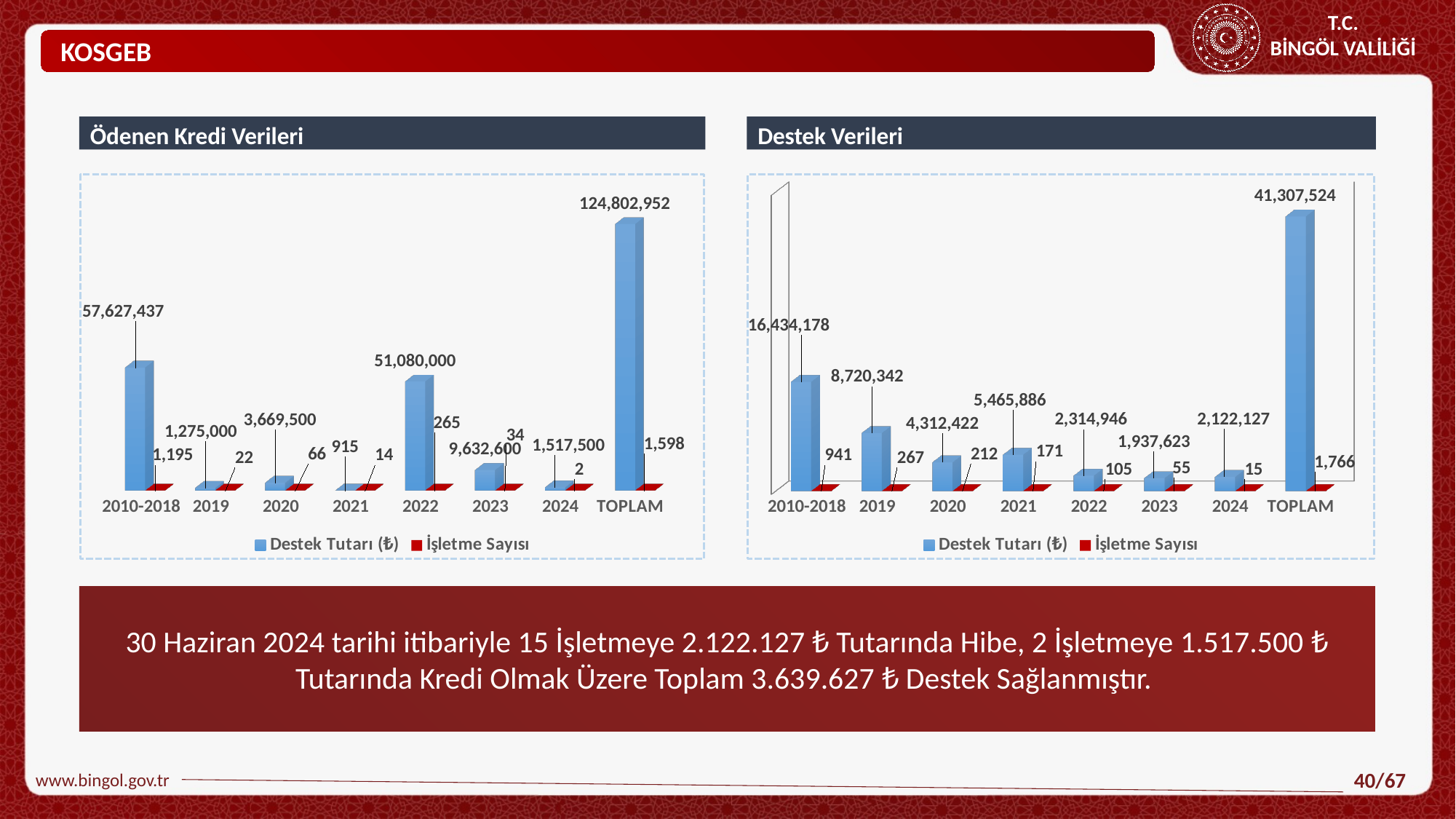
In the 'Destek Verileri' chart, what is the Destek Tutarı (₺) value for 2019? 8,720,342 In the 'Ödenen Kredi Verileri' chart, what is the İşletme Sayısı value for 2010-2018? 1,195 In the 'Ödenen Kredi Verileri' chart, what is the Destek Tutarı (₺) value for TOPLAM? 124,802,952 In the 'Ödenen Kredi Verileri' chart, what is the Destek Tutarı (₺) value for 2022? 51,080,000 How many categories are shown on the x axis of the 'Destek Verileri' chart? 8 What type of chart is the 'Destek Verileri' chart? Bar chart In the 'Destek Verileri' chart, which year category (excluding TOPLAM) has the highest Destek Tutarı (₺)? 2010-2018 In the 'Destek Verileri' chart, what is the difference between the Destek Tutarı (₺) values for 2021 and 2020? 1,153,464 In the 'Ödenen Kredi Verileri' chart, which category has the lowest Destek Tutarı (₺)? 2021 How many series does the legend of the 'Ödenen Kredi Verileri' chart list? 2 In the 'Destek Verileri' chart, what is the İşletme Sayısı value for 2024? 15 In the 'Ödenen Kredi Verileri' chart, which is larger, the Destek Tutarı (₺) for 2020 or for 2023? 2023